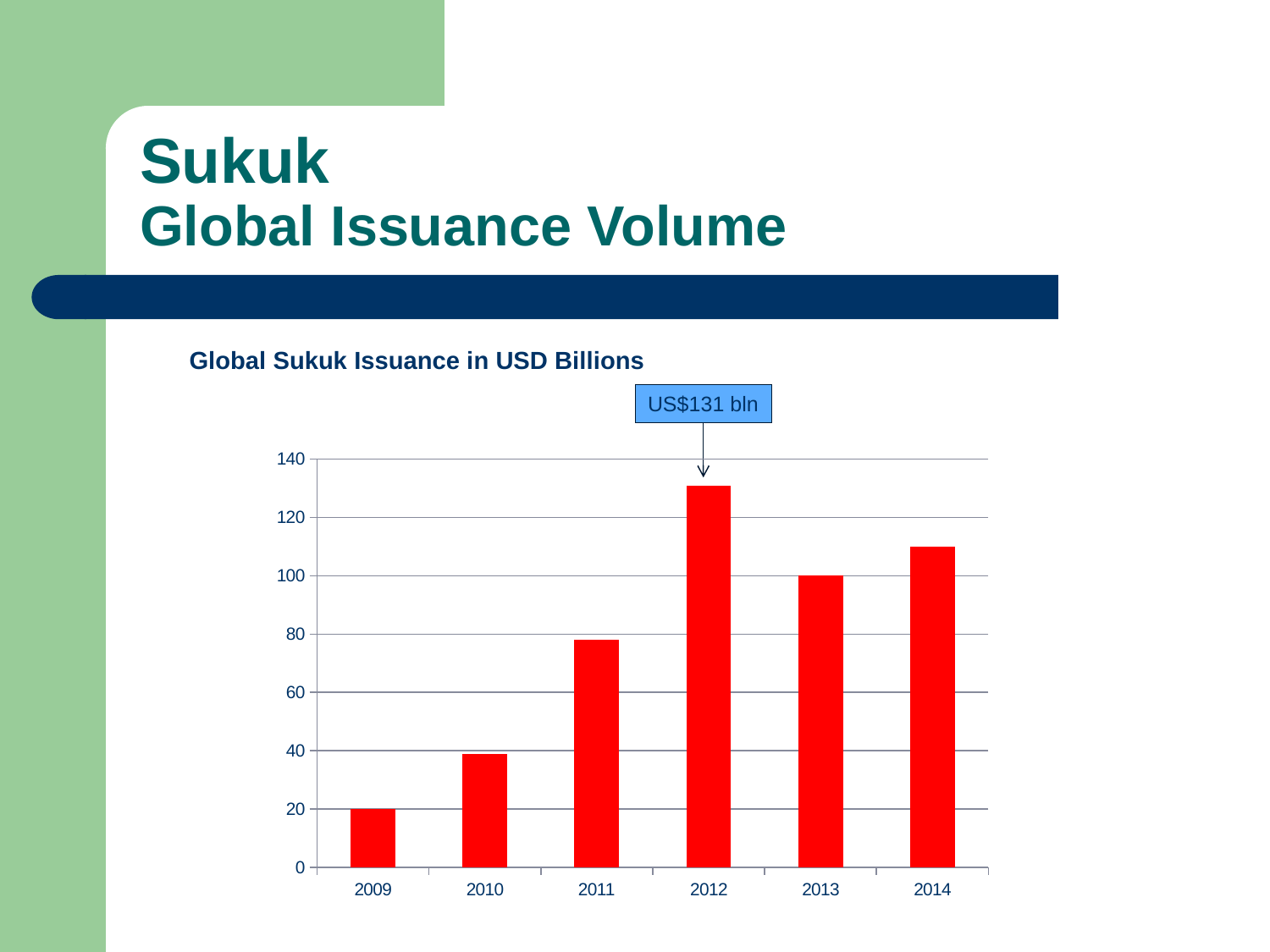
Do the values rise or fall from 2009 to 2012? rise What is the global sukuk issuance value for 2013? 100 How many years are shown on the x axis of the chart? 6 What is the global sukuk issuance value shown for 2012? US$131 bln Which year has the larger issuance, 2010 or 2011? 2011 Which year has the highest global sukuk issuance? 2012 Is the value for 2014 greater or less than 120? less Which year has the larger issuance, 2013 or 2014? 2014 What kind of chart is used to show global sukuk issuance? bar chart Which year has the lowest global sukuk issuance? 2009 What is the global sukuk issuance value for 2009? 20